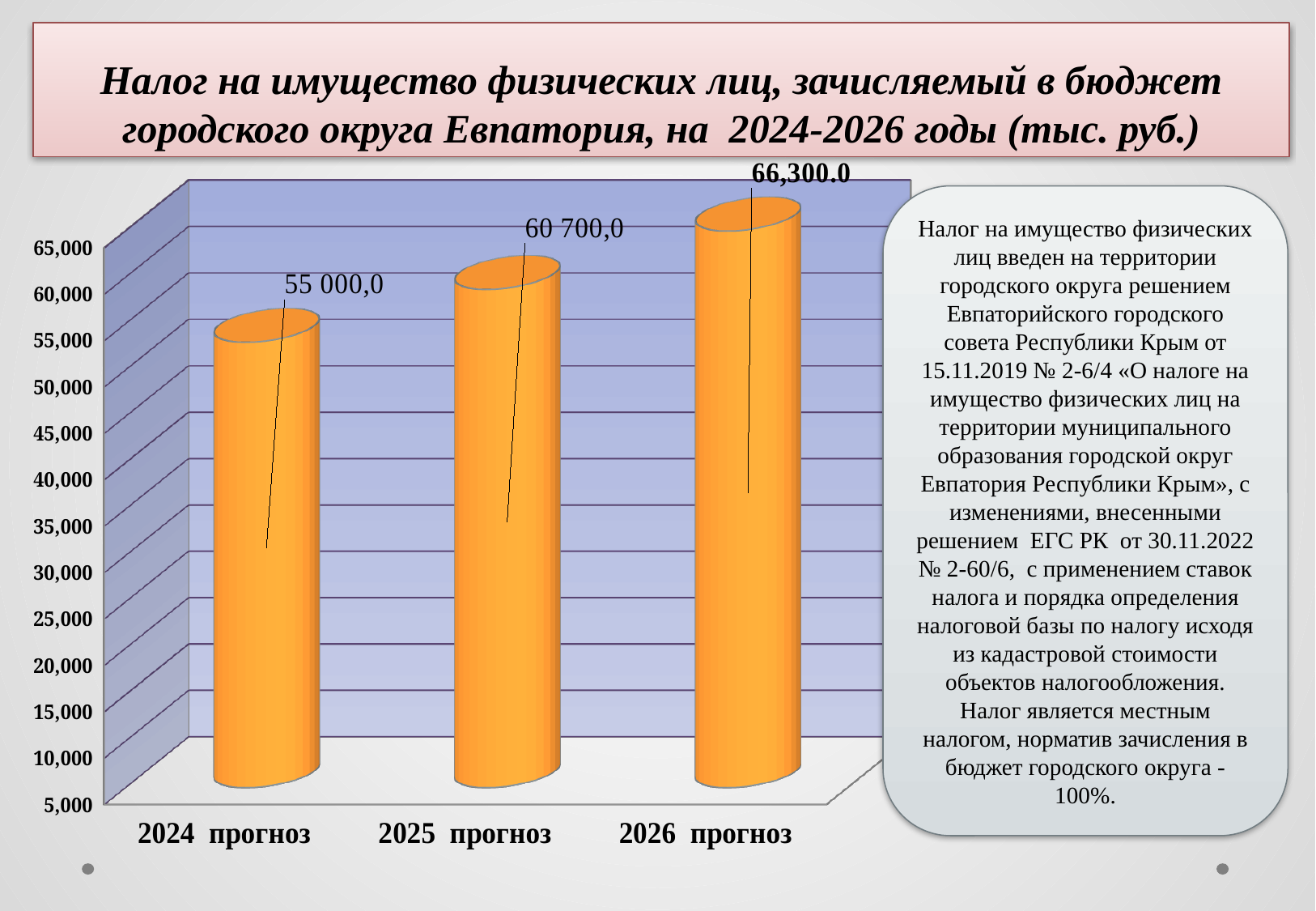
What kind of chart is shown on the slide? bar chart Is the value for 2024 прогноз greater or less than 50,000? greater How many categories are shown on the x axis? 3 What is the difference between the values for 2026 прогноз and 2024 прогноз? 11 300 Which year has the highest value? 2026 прогноз Do the values rise or fall from 2024 прогноз to 2026 прогноз? rise Which year has the lowest value? 2024 прогноз What is the value for 2026 прогноз? 66,300.0 What is the difference between the values for 2025 прогноз and 2024 прогноз? 5 700 Which is larger, the value for 2025 прогноз or 2026 прогноз? 2026 прогноз What is the value for 2024 прогноз? 55 000,0 What is the value for 2025 прогноз? 60 700,0